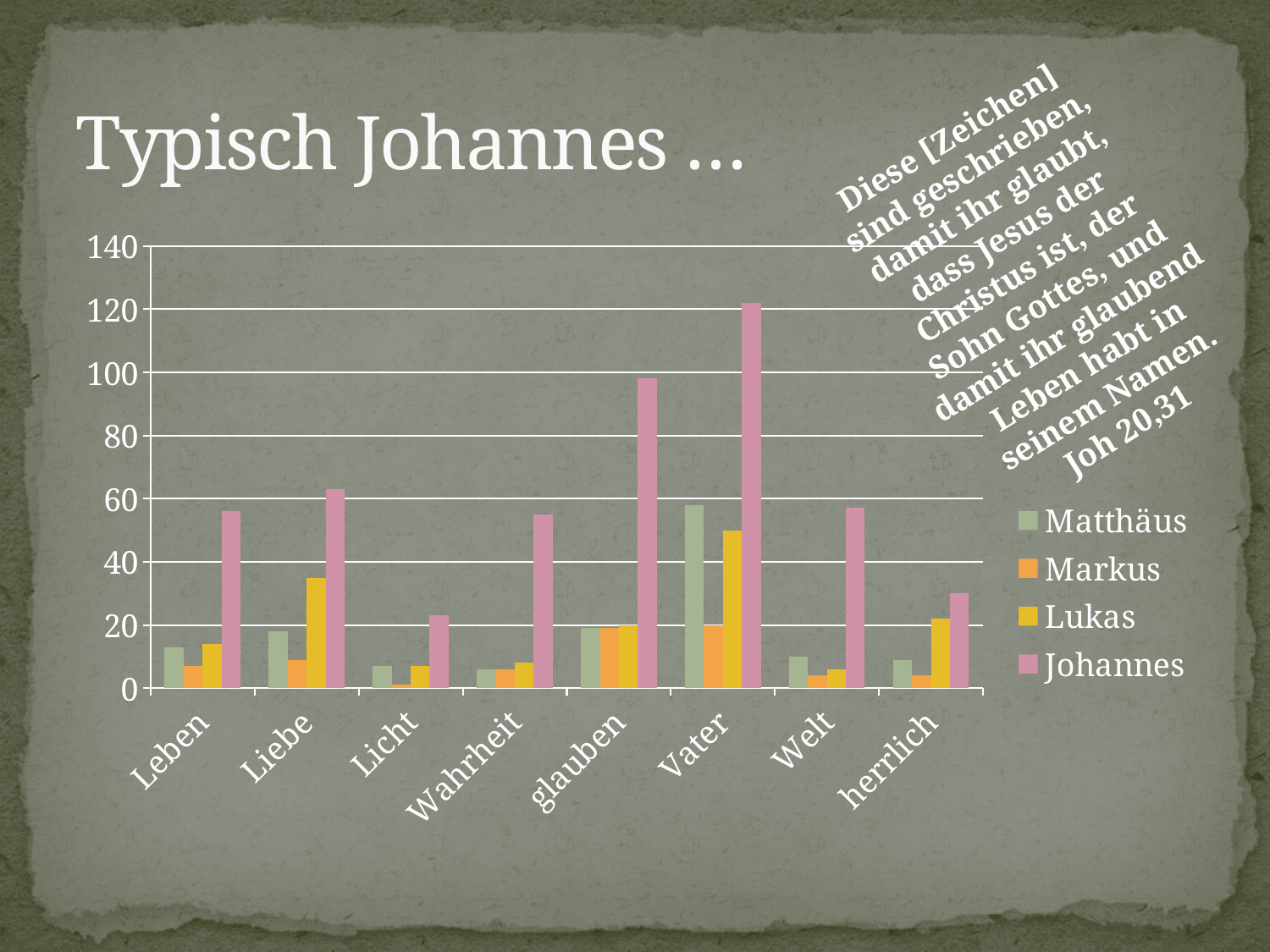
What is the title of the slide containing the chart? Typisch Johannes … Which category has the highest value for the Matthäus series? Vater Which category has the lowest value for the Johannes series? Licht Is the value for Johannes in the glauben category greater or less than 80? greater Is the value for Johannes in the Vater category greater or less than 100? greater Is the value for Matthäus in the Vater category greater or less than 40? greater In the Liebe category, which series has the larger value, Lukas or Matthäus? Lukas How many series does the chart's legend list? 4 What kind of chart is shown on the slide? bar chart How many categories are shown on the x axis of the chart? 8 Which category has the highest value for the Johannes series? Vater